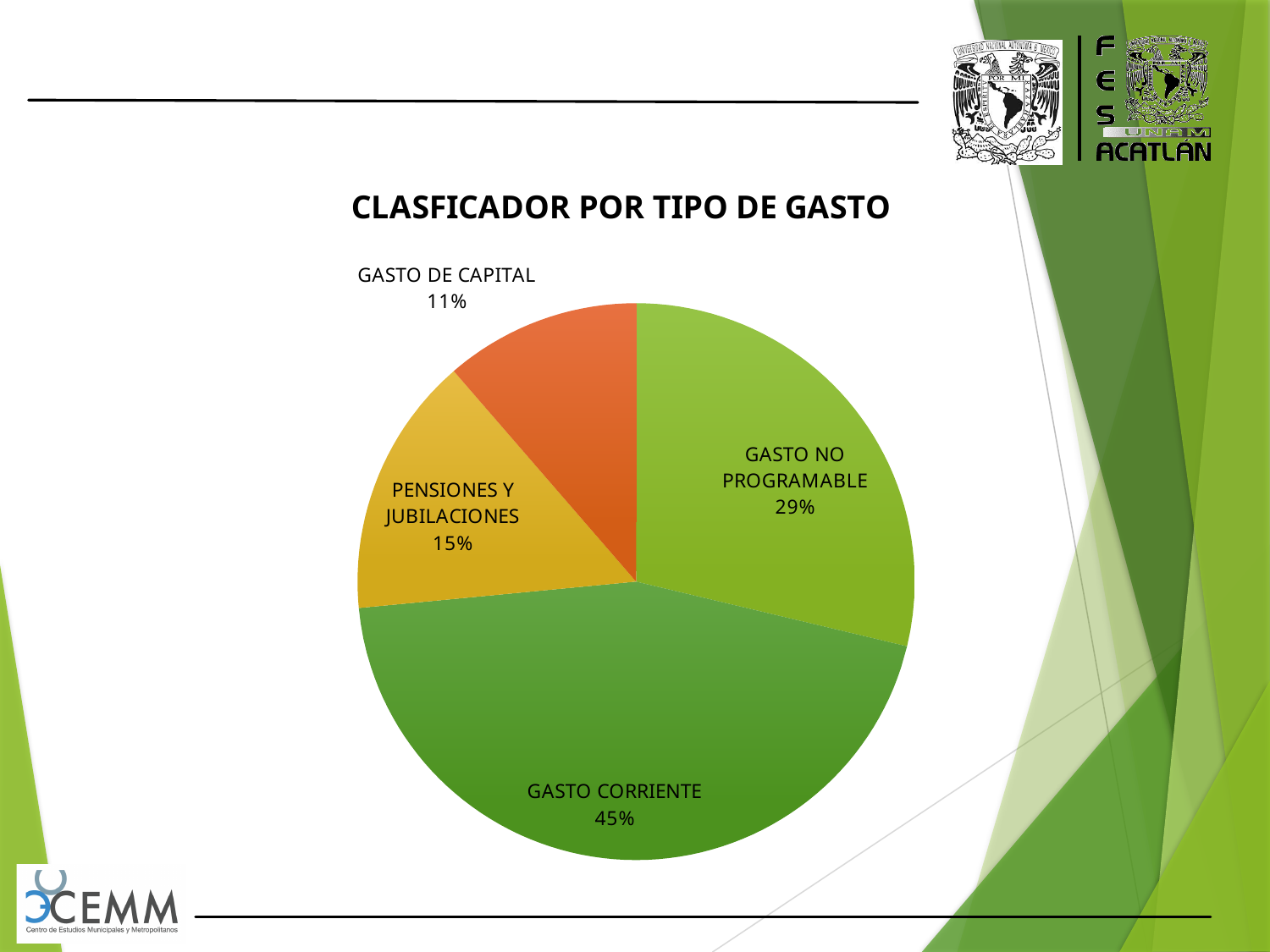
How many categories are shown in the pie chart? 4 What colour is the GASTO DE CAPITAL slice? orange What share of the pie does GASTO DE CAPITAL represent? 11% What type of chart is shown on the slide? pie chart What share of the pie does GASTO CORRIENTE represent? 45% What share of the pie does PENSIONES Y JUBILACIONES represent? 15% What is the difference in percentage points between GASTO CORRIENTE and GASTO NO PROGRAMABLE? 16 What is the title of the chart? CLASFICADOR POR TIPO DE GASTO Which category has the largest slice of the pie? GASTO CORRIENTE Which is larger, PENSIONES Y JUBILACIONES or GASTO DE CAPITAL? PENSIONES Y JUBILACIONES Which category has the smallest slice of the pie? GASTO DE CAPITAL